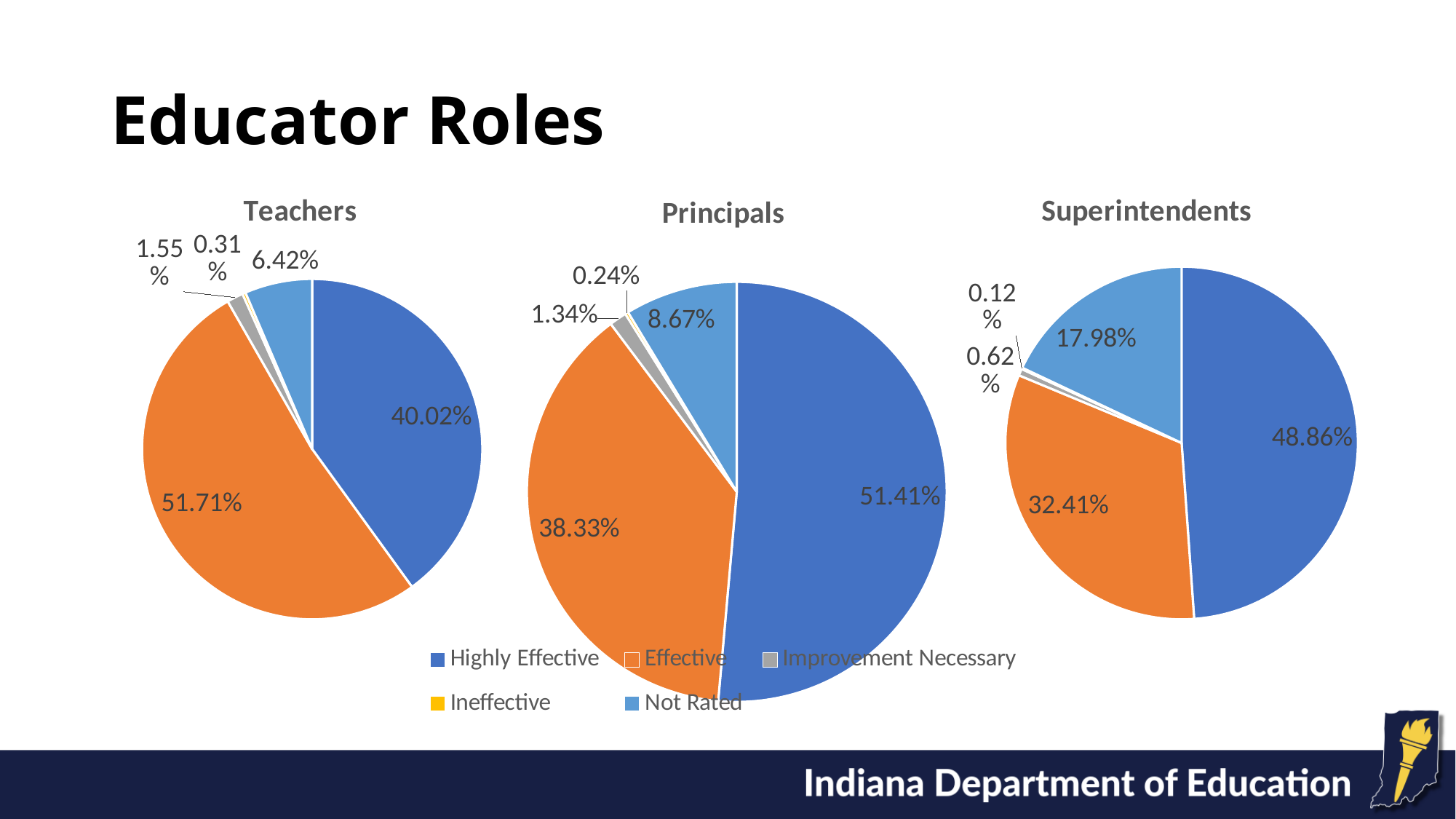
In the Teachers chart, what is the value for Effective? 51.71% Which colour represents Not Rated in the legend? Light blue How many series does the legend list? 5 In the Superintendents chart, what is the difference between Highly Effective and Effective? 16.45% In the Principals chart, which is larger, Not Rated or Improvement Necessary? Not Rated How many pie charts are on the slide? 3 What kind of charts are shown on the slide? Pie charts In the Teachers chart, what is the value for Ineffective? 0.31% In the Principals chart, what is the value for Highly Effective? 51.41% In the Teachers chart, which category has the largest share? Effective In the Superintendents chart, what is the value for Not Rated? 17.98% In the Principals chart, which category has the smallest share? Ineffective